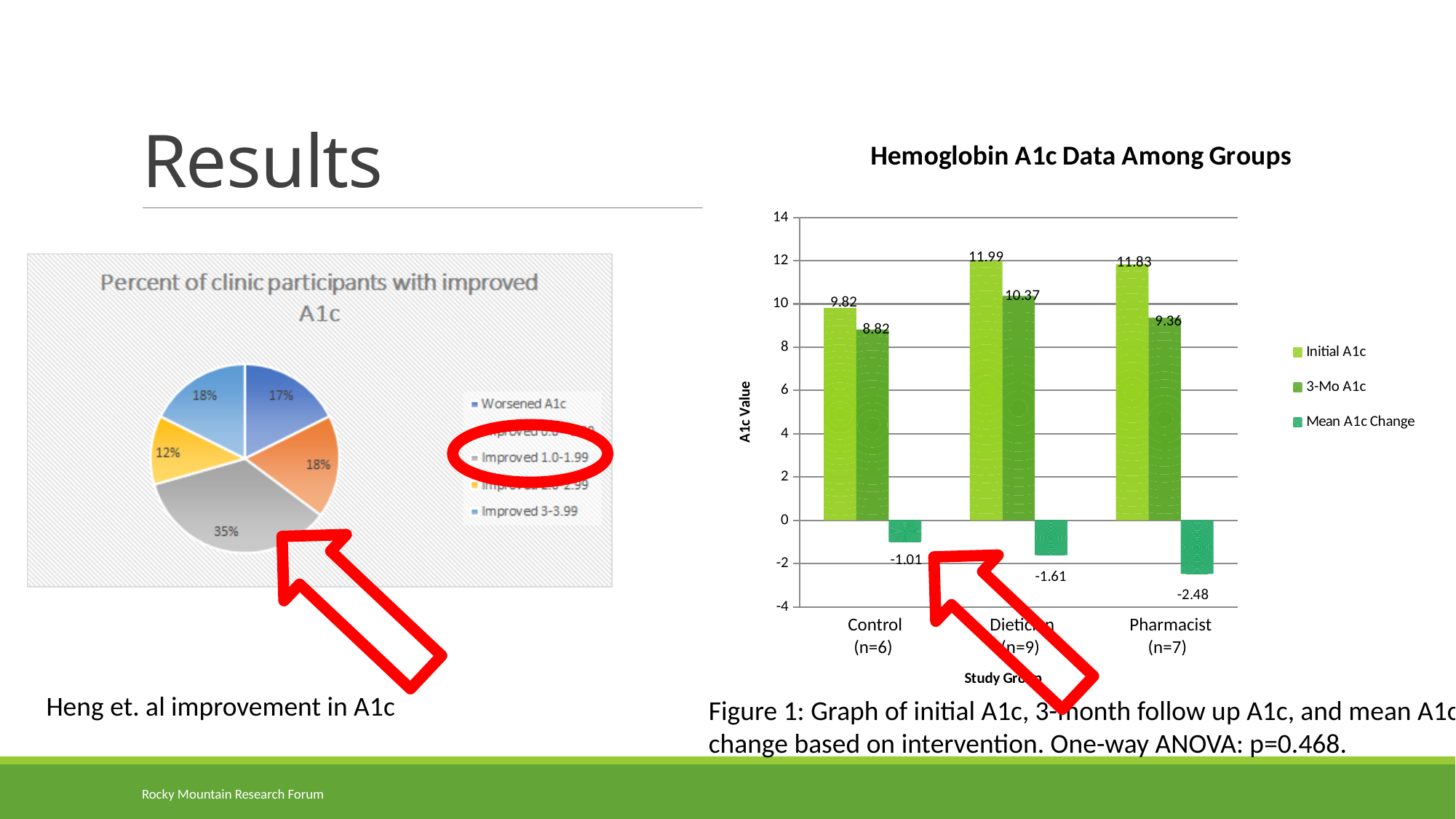
How many slices does the pie chart on the left have? 5 In the Hemoglobin A1c Data Among Groups chart, which is larger: the 3-Mo A1c for Control or the 3-Mo A1c for Pharmacist? Pharmacist In the pie chart on the left, what percentage of clinic participants had Worsened A1c? 17% In the Hemoglobin A1c Data Among Groups chart, what is the 3-Mo A1c value for the Pharmacist group? 9.36 How many series does the legend of the Hemoglobin A1c Data Among Groups chart list? 3 What kind of chart is the Hemoglobin A1c Data Among Groups chart? bar chart In the Hemoglobin A1c Data Among Groups chart, what is the difference between the Initial A1c and the 3-Mo A1c for the Control group? 1.00 In the Hemoglobin A1c Data Among Groups chart, which group has the lowest 3-Mo A1c value? Control How many study groups are shown on the x axis of the Hemoglobin A1c Data Among Groups chart? 3 In the pie chart on the left, which category has the largest slice? Improved 1.0-1.99 In the Hemoglobin A1c Data Among Groups chart, what is the Mean A1c Change for the Control group? -1.01 In the Hemoglobin A1c Data Among Groups chart, what is the Initial A1c value for the Control group? 9.82